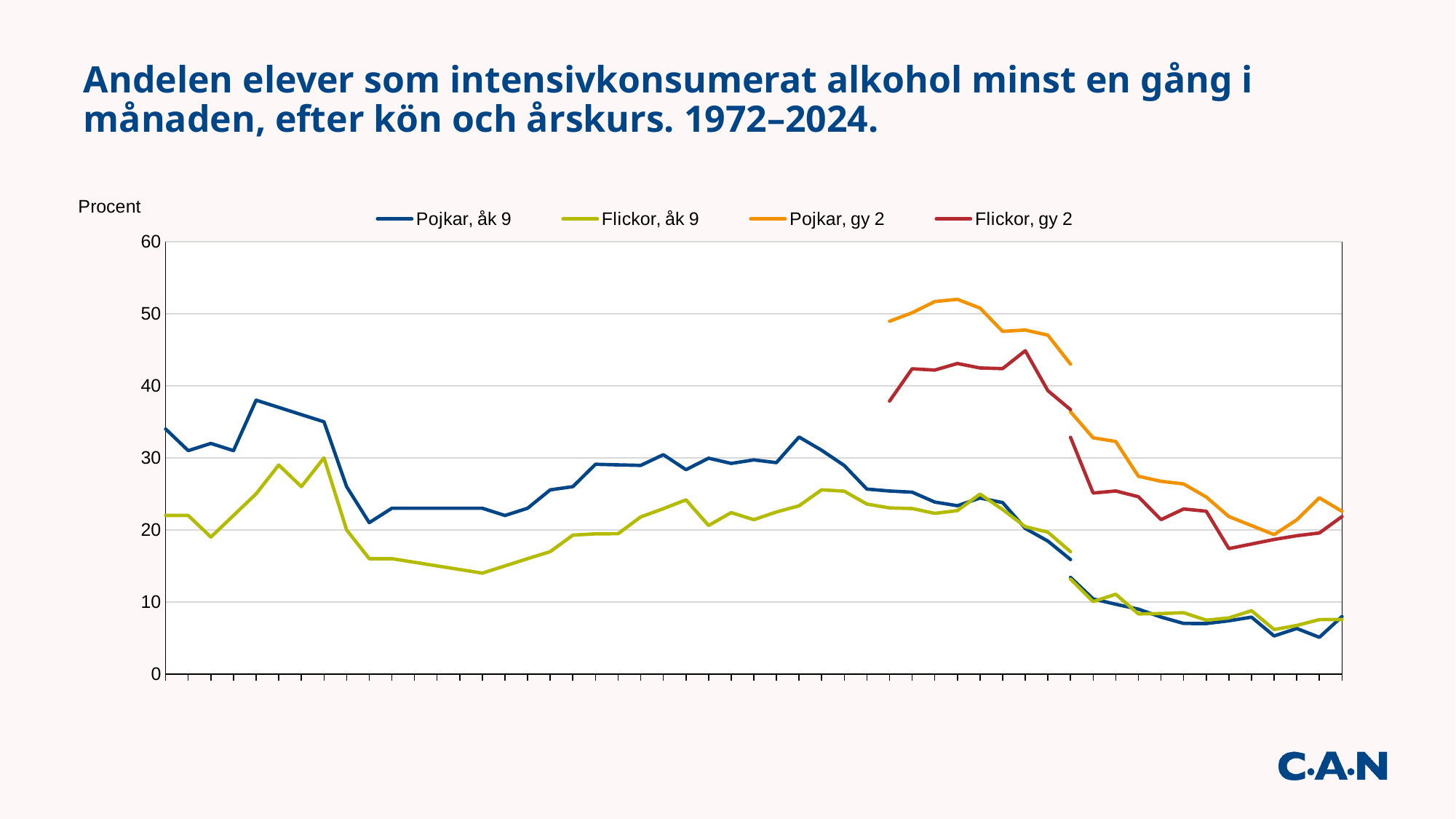
Is the highest value reached by the Pojkar, gy 2 series greater or less than 50? greater Is the first (leftmost) value of the Pojkar, åk 9 series greater or less than 30? greater Is the lowest value reached by the Pojkar, åk 9 series greater or less than 10? less Which series reaches the highest value anywhere on the chart? Pojkar, gy 2 What kind of chart is shown on the slide? line chart At the leftmost point of the chart, which is higher: Pojkar, åk 9 or Flickor, åk 9? Pojkar, åk 9 Which series has the higher peak value: Pojkar, gy 2 or Flickor, gy 2? Pojkar, gy 2 What label is shown on the vertical axis of the chart? Procent Overall, do the values of the Pojkar, åk 9 series rise or fall from left to right across the chart? fall How many series does the legend list? 4